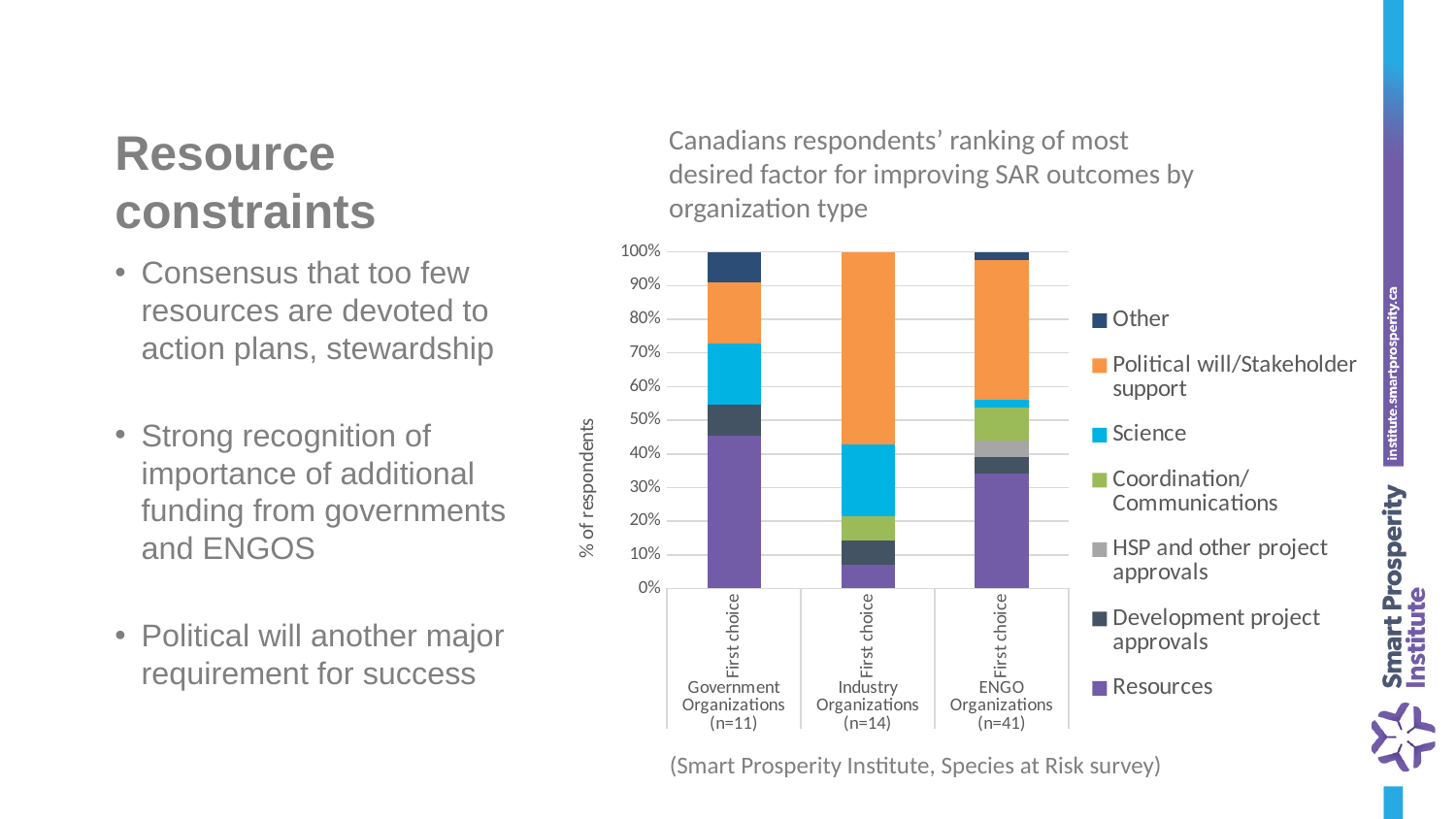
What is the label on the vertical axis? % of respondents Is the Political will/Stakeholder support share for Industry Organizations greater or less than 50%? greater How many organization types (categories) are plotted on the x axis? 3 Which organization type has the largest Resources segment? Government Organizations (n=11) How many series does the legend list? 7 Which has the larger Science segment: Government Organizations or ENGO Organizations? Government Organizations Is the Resources share for ENGO Organizations greater or less than 30%? greater Which organization type has the largest Political will/Stakeholder support segment? Industry Organizations (n=14) Is the Resources share for Government Organizations greater or less than 40%? greater What kind of chart is shown on the slide? Stacked bar chart Which has the larger Resources segment: Government Organizations or Industry Organizations? Government Organizations